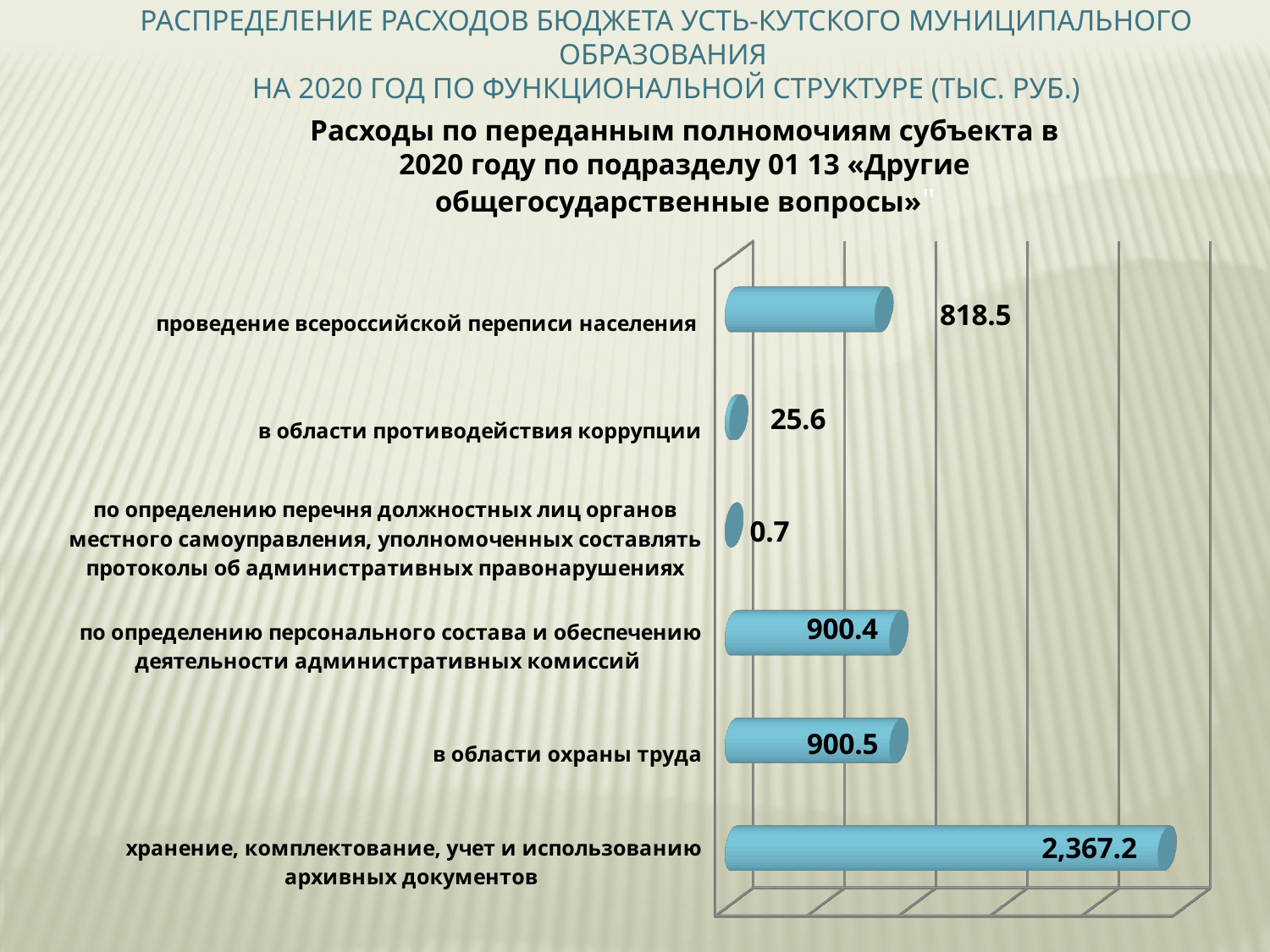
What is the value for «в области охраны труда»? 900.5 What is the title of the chart? Расходы по переданным полномочиям субъекта в 2020 году по подразделу 01 13 «Другие общегосударственные вопросы» What is the difference between the value for «проведение всероссийской переписи населения» and the value for «в области противодействия коррупции»? 792.9 How many categories are shown in the chart? 6 Which category has the highest value? хранение, комплектование, учет и использованию архивных документов What kind of chart is shown on the slide? bar chart What is the value for «хранение, комплектование, учет и использованию архивных документов»? 2,367.2 Which is larger: the value for «проведение всероссийской переписи населения» or the value for «в области охраны труда»? в области охраны труда Which category has the lowest value? по определению перечня должностных лиц органов местного самоуправления, уполномоченных составлять протоколы об административных правонарушениях What is the value for «проведение всероссийской переписи населения»? 818.5 What is the value for «в области противодействия коррупции»? 25.6 What is the difference between the value for «хранение, комплектование, учет и использованию архивных документов» and the value for «в области охраны труда»? 1,466.7